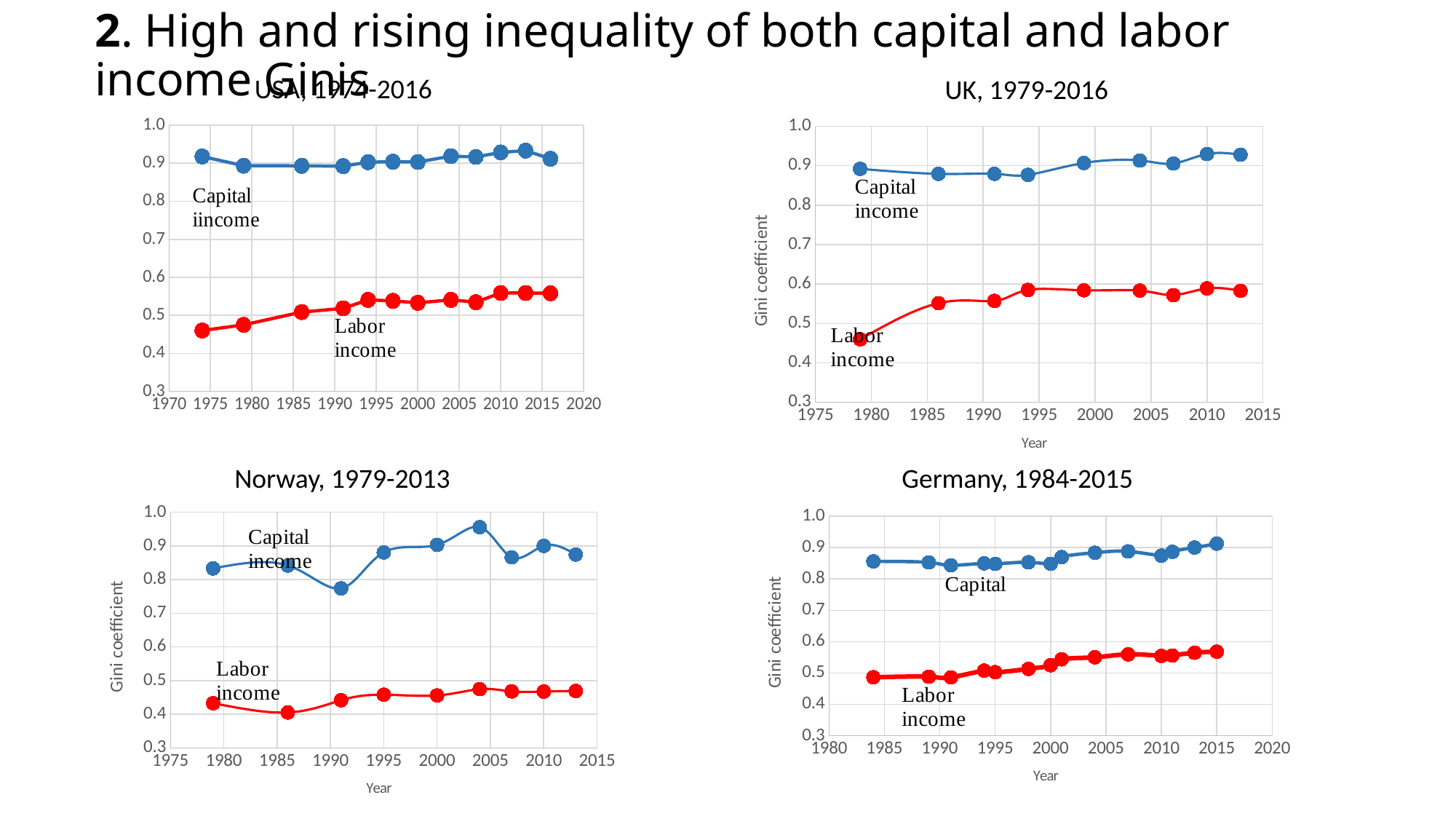
How many series are plotted in the 'Germany, 1984-2015' chart? 2 What is the y-axis label of the 'UK, 1979-2016' chart? Gini coefficient In the 'Norway, 1979-2013' chart, in which year does capital income reach its highest value? 2004 What kind of chart is the 'Norway, 1979-2013' chart? line chart In the 'USA, 1974-2016' chart, is the labor income value for 1974 greater or less than 0.5? less In the 'Norway, 1979-2013' chart, is the capital income value for 1991 greater or less than 0.8? less In the 'Norway, 1979-2013' chart, which series has the larger value in 2004, capital income or labor income? Capital income In the 'Germany, 1984-2015' chart, does labor income rise or fall from 1984 to 2015? rises In the 'Norway, 1979-2013' chart, in which year is labor income at its lowest? 1986 In the 'Germany, 1984-2015' chart, is the labor income value for 2015 greater or less than 0.6? less